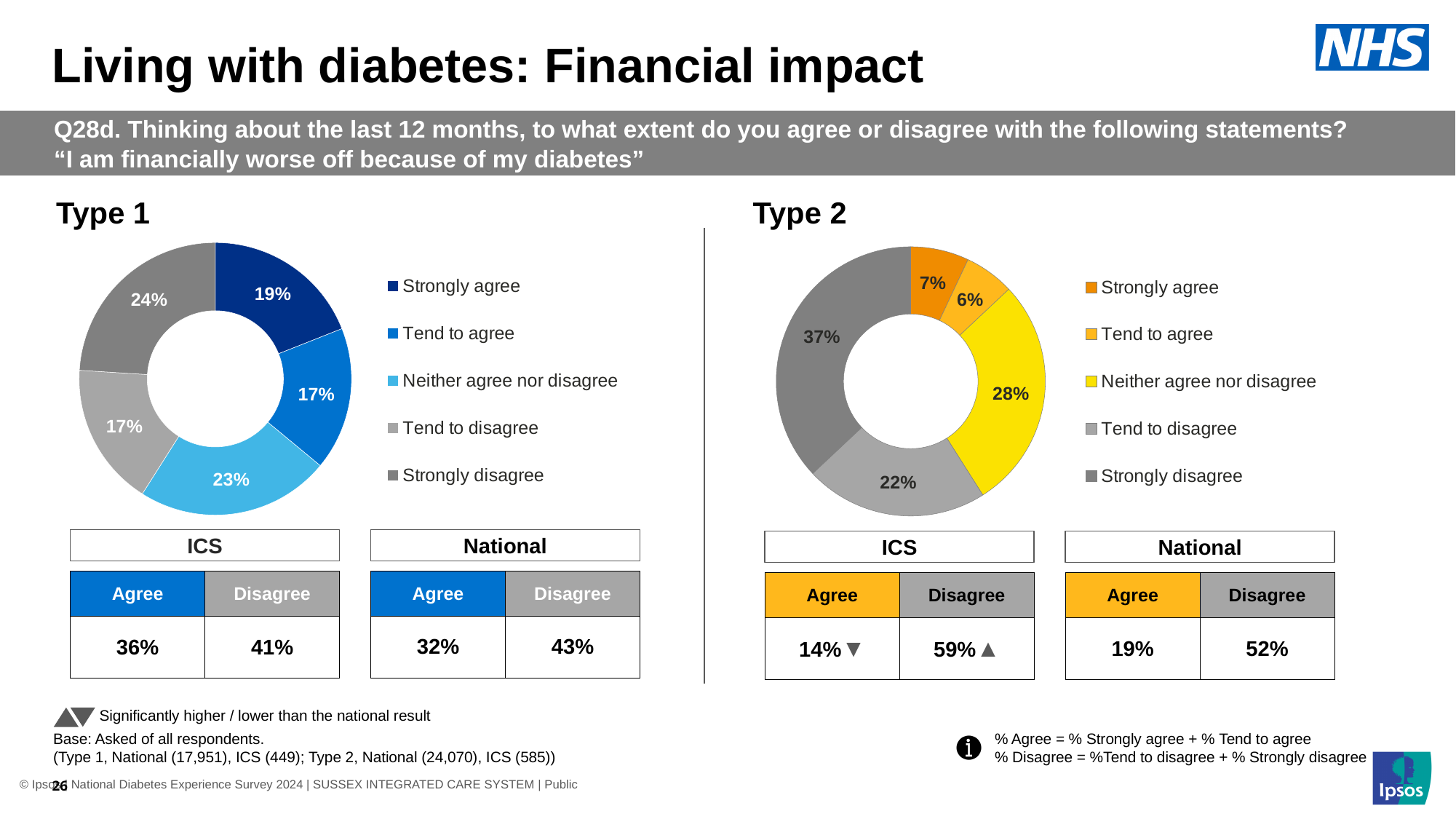
In the Type 2 chart, which is larger: the share for Tend to disagree or the share for Neither agree nor disagree? Neither agree nor disagree In the Type 2 chart, what percentage of respondents said they strongly disagree? 37% In the Type 1 chart, which is larger: the share for Strongly agree or the share for Tend to agree? Strongly agree In the Type 2 chart, what colour is the Neither agree nor disagree segment? Yellow What kind of chart is used to show the Type 2 results? Donut (pie) chart In the Type 1 chart, what percentage of respondents said they neither agree nor disagree? 23% How many response categories does the legend of the Type 1 chart list? 5 In the Type 1 chart, which response category has the largest share? Strongly disagree In the Type 1 chart, what percentage of respondents said they strongly agree? 19% In the Type 2 chart, what is the difference in percentage points between Strongly disagree and Neither agree nor disagree? 9 In the Type 2 chart, which response category has the smallest share? Tend to agree In the Type 2 chart, what percentage of respondents said they tend to agree? 6%